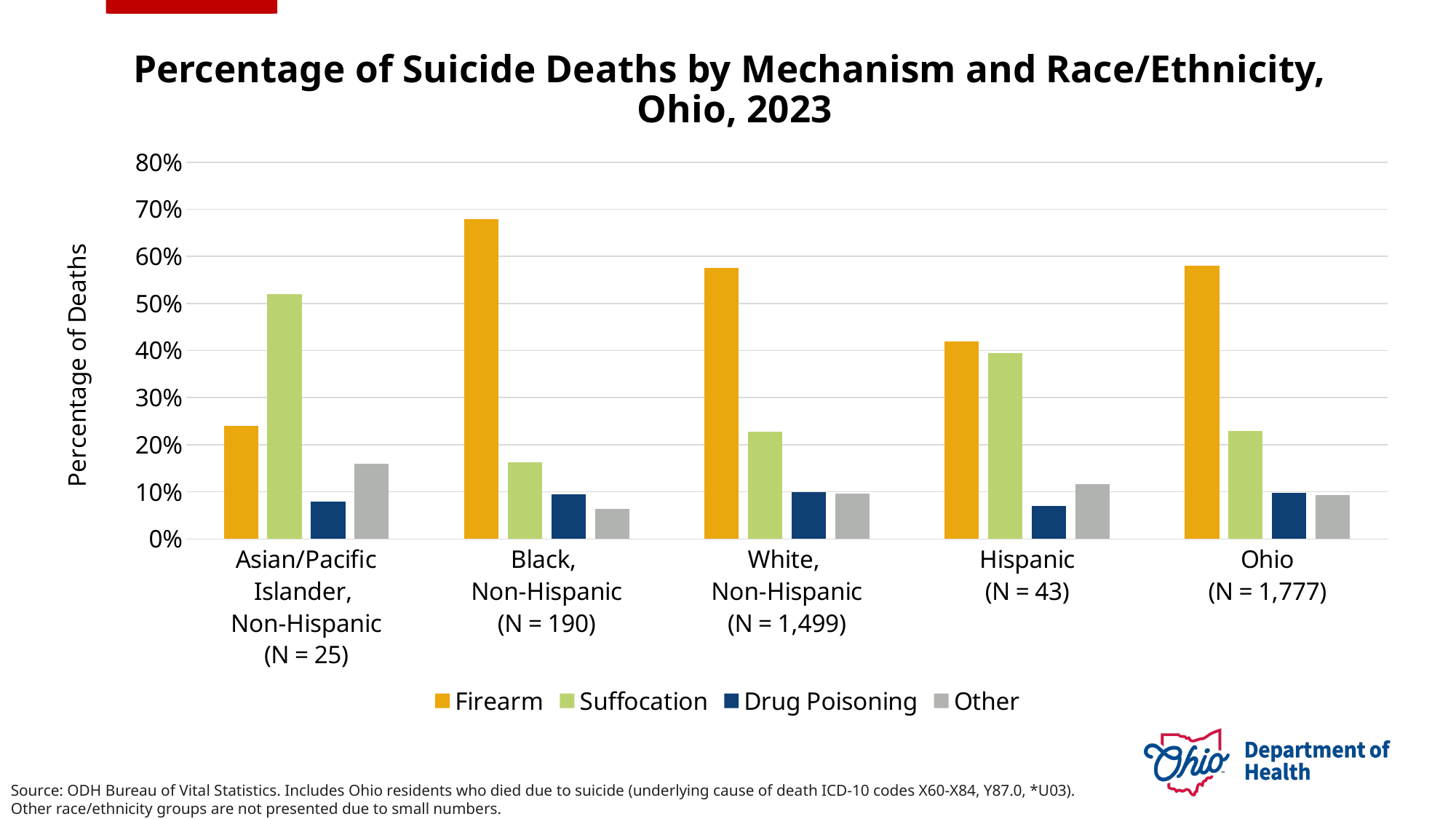
What kind of chart is shown on the slide? Bar chart For Ohio (N = 1,777), which mechanism has the highest bar? Firearm Is the Suffocation value for Asian/Pacific Islander, Non-Hispanic greater or less than 50%? greater For Asian/Pacific Islander, Non-Hispanic, which is larger: Firearm or Suffocation? Suffocation For Black, Non-Hispanic, which is larger: Suffocation or Other? Suffocation Which group has the lowest Firearm bar? Asian/Pacific Islander, Non-Hispanic How many race/ethnicity groups are shown on the x axis? 5 What is the title of the chart? Percentage of Suicide Deaths by Mechanism and Race/Ethnicity, Ohio, 2023 How many series does the legend list? 4 Is the Firearm value for Black, Non-Hispanic greater or less than 60%? greater Is the Other value for Black, Non-Hispanic greater or less than 10%? less Which group has the highest Firearm bar? Black, Non-Hispanic